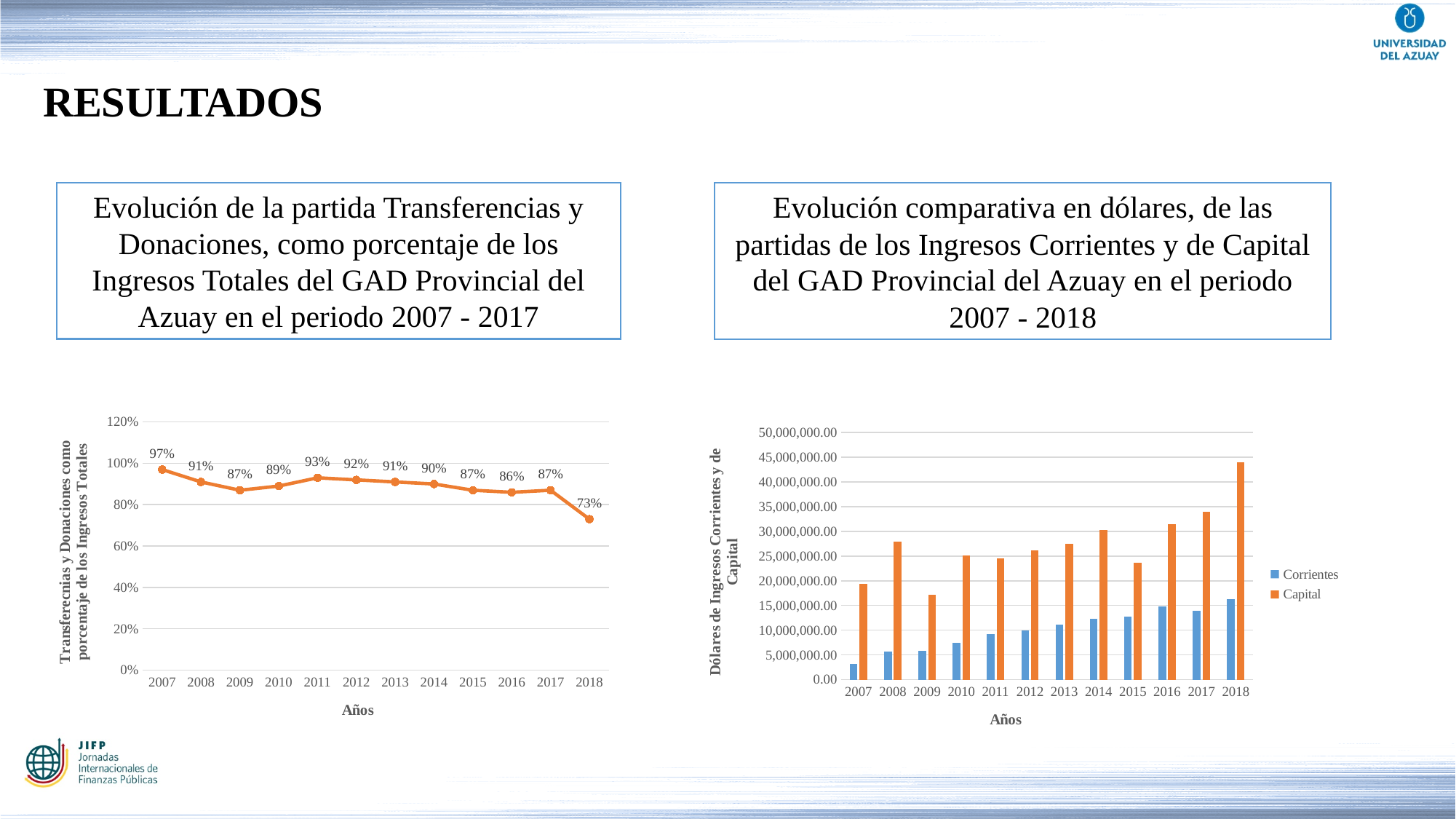
In the right chart, do the Corrientes values generally rise or fall from 2007 to 2018? rise In the left chart, which year has the lowest value? 2018 In the left chart, how many data points are plotted? 12 In the left chart, what is the value for 2007? 97% In the right chart, how many series does the legend list? 2 What kind of chart is the left chart? line chart In the left chart, which year has the highest value? 2007 In the right chart, is the Capital value for 2018 greater or less than 40,000,000.00? greater In the left chart, what is the value for 2018? 73% In the left chart, what is the difference between the values for 2007 and 2018? 24% In the right chart, which is larger in 2012, Corrientes or Capital? Capital In the left chart, what is the value for 2011? 93%